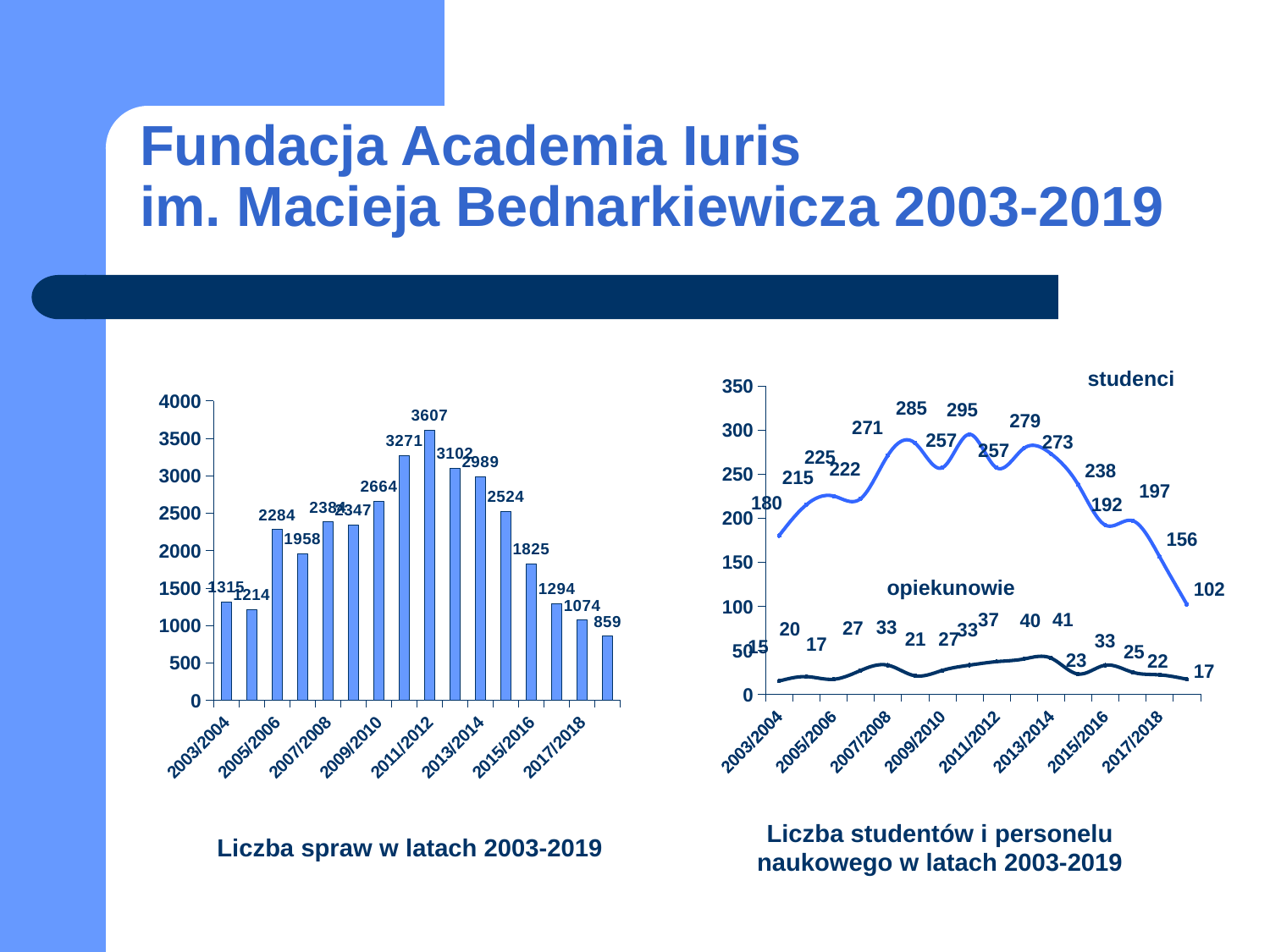
In the left chart 'Liczba spraw w latach 2003-2019', what is the lowest value shown? 859 In the left chart 'Liczba spraw w latach 2003-2019', what is the difference between the highest value (3607) and the lowest value (859)? 2748 In the left chart 'Liczba spraw w latach 2003-2019', which is larger: the value for 2015/2016 or the value for 2017/2018? 2015/2016 In the left chart 'Liczba spraw w latach 2003-2019', how many bars are plotted? 16 In the left chart 'Liczba spraw w latach 2003-2019', what is the value for 2011/2012? 3607 How many series are plotted in the right chart 'Liczba studentów i personelu naukowego w latach 2003-2019'? 2 What kind of chart is the right chart, 'Liczba studentów i personelu naukowego w latach 2003-2019'? line chart In the right chart 'Liczba studentów i personelu naukowego w latach 2003-2019', what is the highest value of the 'studenci' series? 295 In the left chart 'Liczba spraw w latach 2003-2019', what is the value for 2003/2004? 1315 In the right chart 'Liczba studentów i personelu naukowego w latach 2003-2019', what is the value of 'studenci' for 2003/2004? 180 In the right chart 'Liczba studentów i personelu naukowego w latach 2003-2019', what is the highest value of the 'opiekunowie' series? 41 What kind of chart is the left chart, 'Liczba spraw w latach 2003-2019'? bar chart